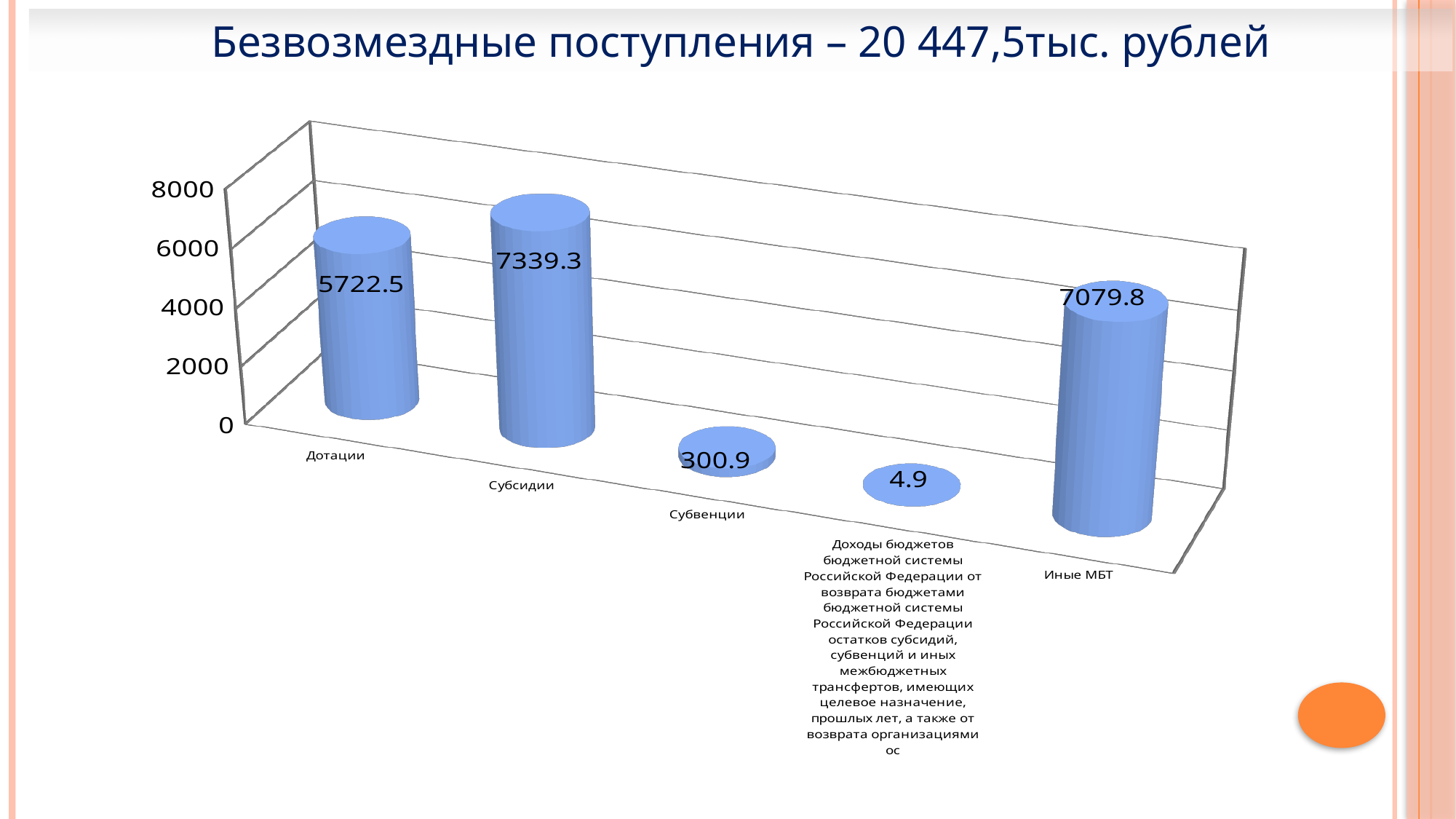
What is the difference between the values for Субсидии and Дотации? 1616.8 How many categories are shown on the chart? 5 What is the value for Дотации? 5722.5 What is the title of the slide? Безвозмездные поступления – 20 447,5тыс. рублей What kind of chart is shown on the slide? Bar chart What is the value for Субсидии? 7339.3 Which category has the highest value? Субсидии What is the value for Субвенции? 300.9 What is the difference between the values for Субсидии and Иные МБТ? 259.5 Which is larger, the value for Дотации or the value for Иные МБТ? Иные МБТ What is the value for Иные МБТ? 7079.8